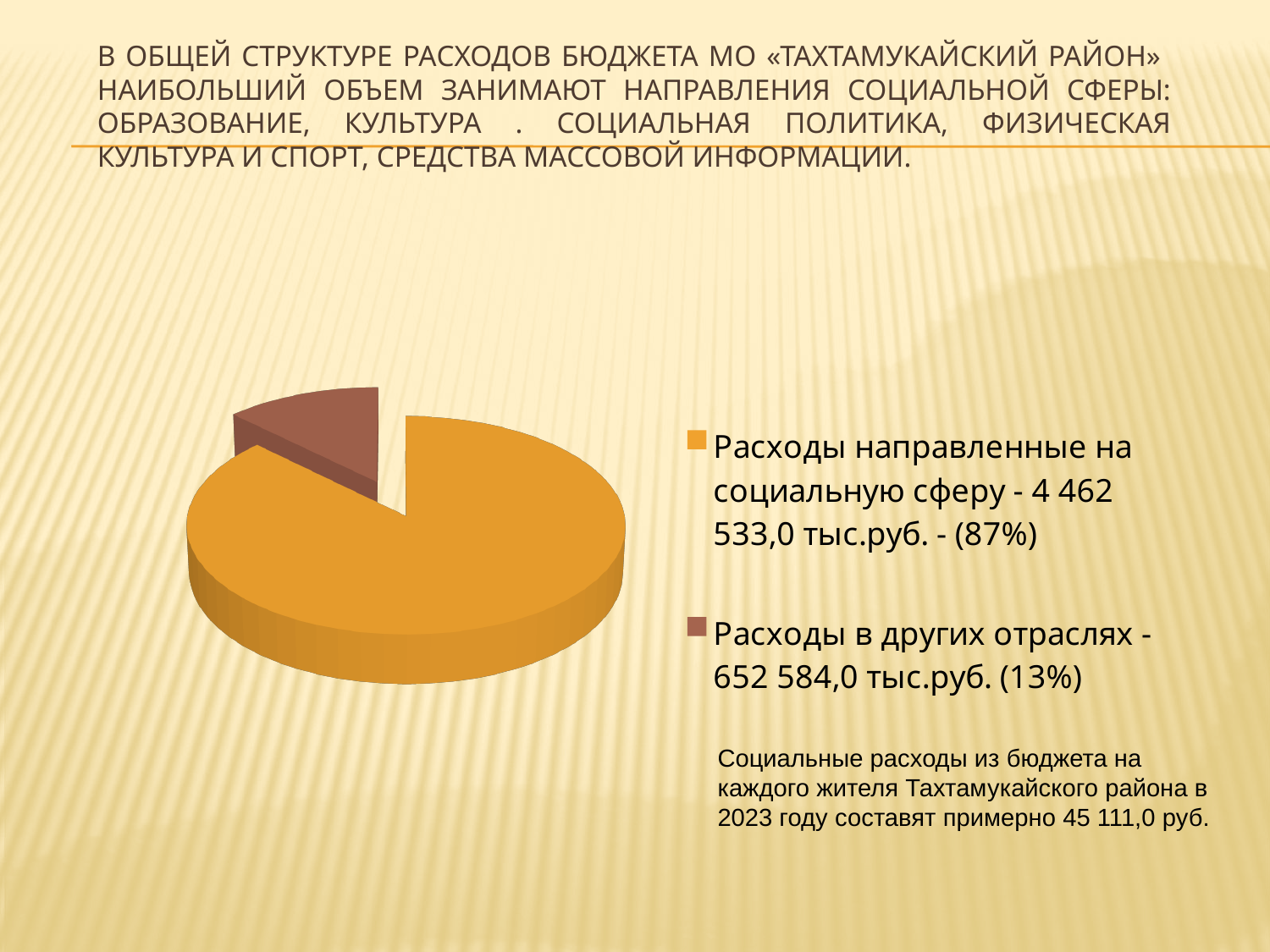
What kind of chart is shown on the slide? Pie chart What value is given for «Расходы в других отраслях»? 652 584,0 тыс.руб. What value is given for «Расходы направленные на социальную сферу»? 4 462 533,0 тыс.руб. How many slices does the pie chart have? 2 By how much do «Расходы направленные на социальную сферу» exceed «Расходы в других отраслях», in тыс.руб.? 3 809 949,0 тыс.руб. What share of the pie does «Расходы в других отраслях» take? 13% Which slice of the pie chart is the smallest? Расходы в других отраслях What share of the pie does «Расходы направленные на социальную сферу» take? 87% Which slice of the pie chart is the largest? Расходы направленные на социальную сферу Which is larger: «Расходы направленные на социальную сферу» or «Расходы в других отраслях»? Расходы направленные на социальную сферу How many entries does the legend of the pie chart list? 2 What colour is the slice for «Расходы в других отраслях»? Brown